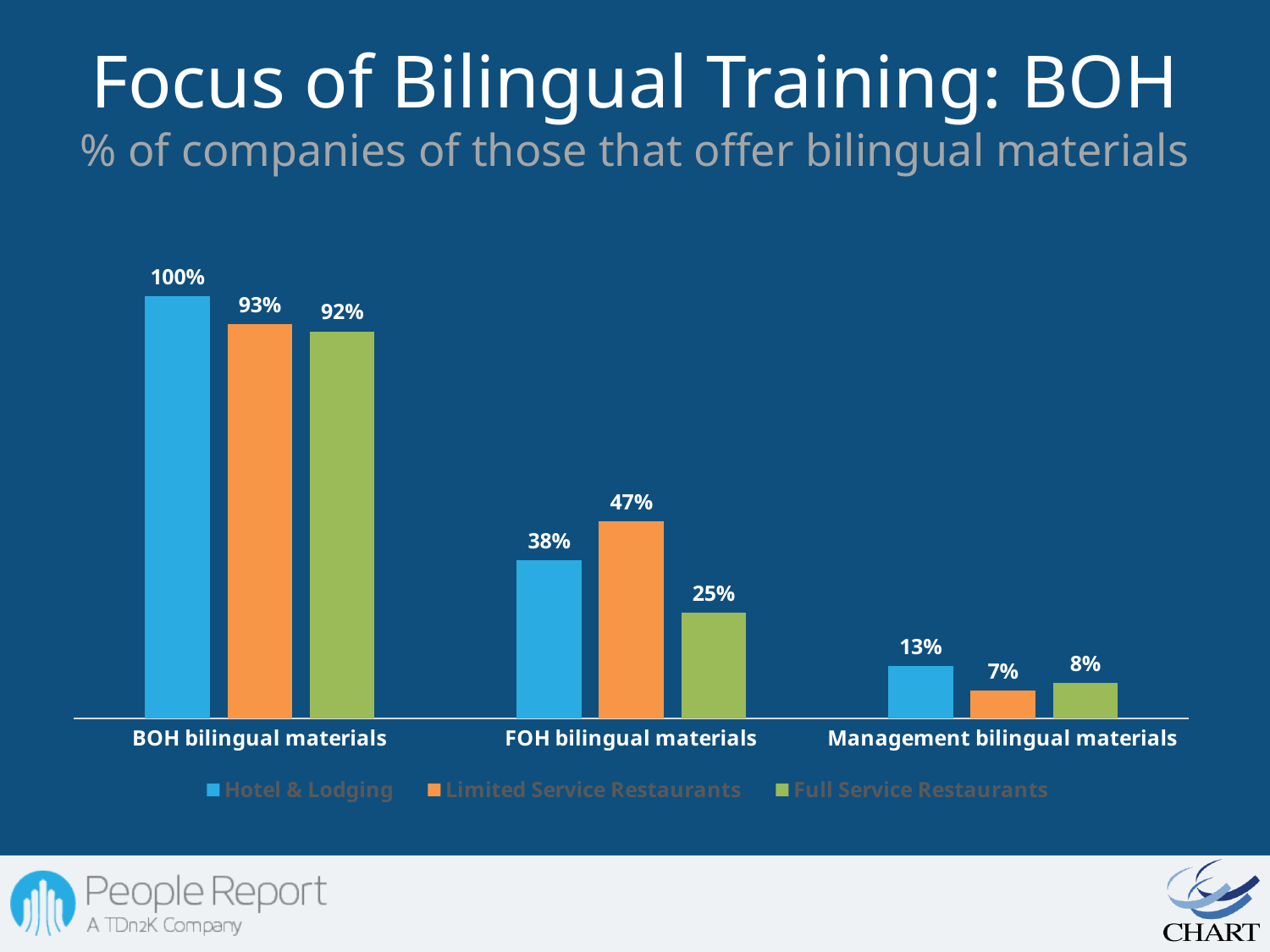
Which series has the lowest value in the Management bilingual materials category? Limited Service Restaurants What kind of chart is shown on the slide? Bar chart What is the value for Hotel & Lodging in the BOH bilingual materials category? 100% What is the value for Full Service Restaurants in the Management bilingual materials category? 8% Do the Hotel & Lodging values rise or fall from BOH bilingual materials to Management bilingual materials? Fall How many categories are shown on the x axis? 3 What is the value for Limited Service Restaurants in the FOH bilingual materials category? 47% How many series does the legend list? 3 What is the title of the chart on the slide? Focus of Bilingual Training: BOH What is the difference between the Hotel & Lodging and Full Service Restaurants values in the FOH bilingual materials category? 13% Which series has the highest value in the FOH bilingual materials category? Limited Service Restaurants Which is larger in the BOH bilingual materials category: Limited Service Restaurants or Full Service Restaurants? Limited Service Restaurants